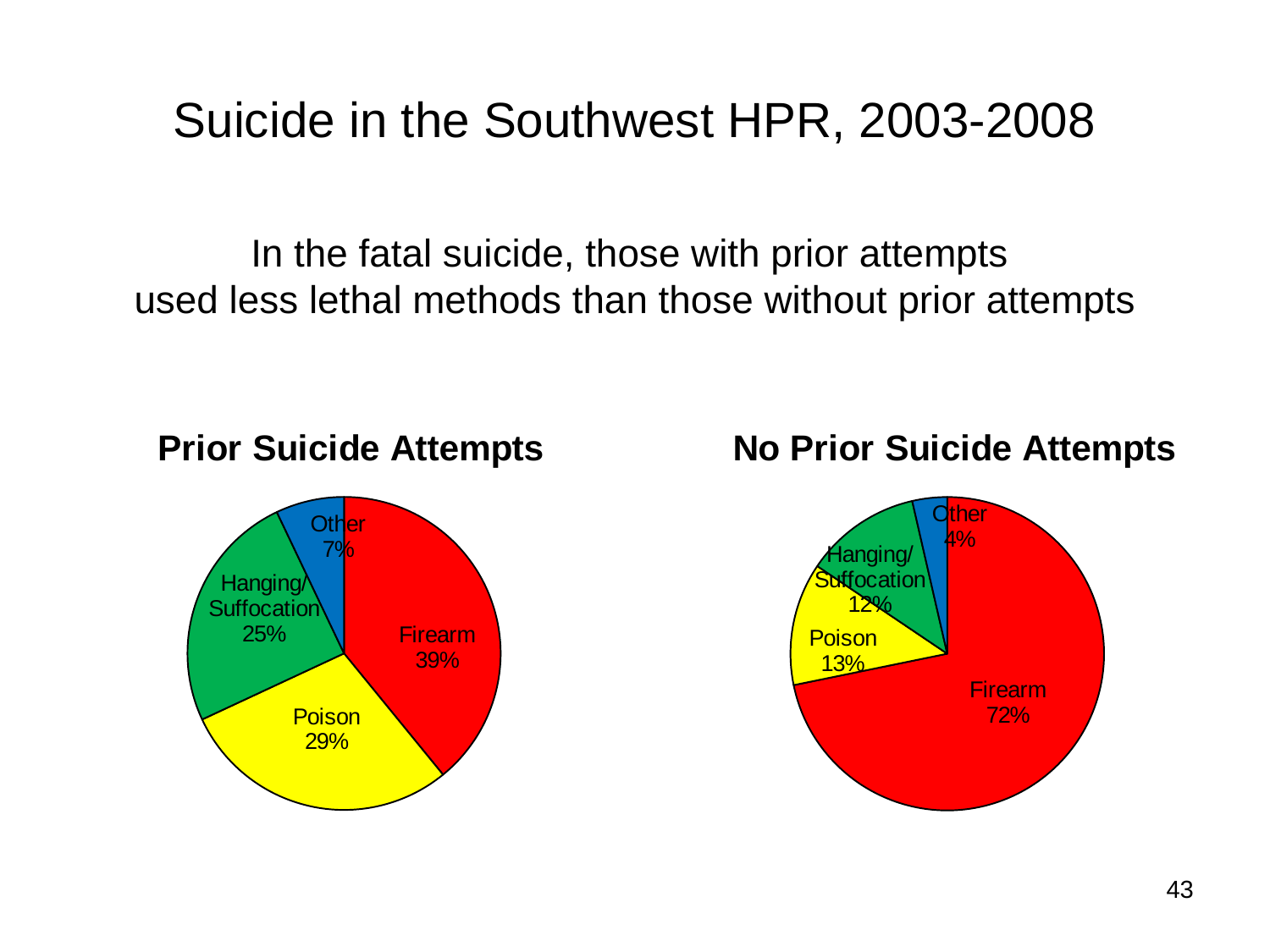
Which chart has the larger Hanging/Suffocation share, Prior Suicide Attempts or No Prior Suicide Attempts? Prior Suicide Attempts In the Prior Suicide Attempts chart, which category has the largest slice? Firearm In the Prior Suicide Attempts chart, what colour is the Poison slice? Yellow In the No Prior Suicide Attempts chart, what is the difference between the Firearm and Poison shares? 59% In the No Prior Suicide Attempts chart, which category has the smallest slice? Other In the No Prior Suicide Attempts chart, what share is Firearm? 72% In the Prior Suicide Attempts chart, what share is Firearm? 39% What kind of chart is the No Prior Suicide Attempts chart? Pie chart How many categories are shown in the Prior Suicide Attempts chart? 4 In the Prior Suicide Attempts chart, what share is Poison? 29% In the No Prior Suicide Attempts chart, what share is Hanging/Suffocation? 12% In the Prior Suicide Attempts chart, what is the difference between the Firearm and Poison shares? 10%